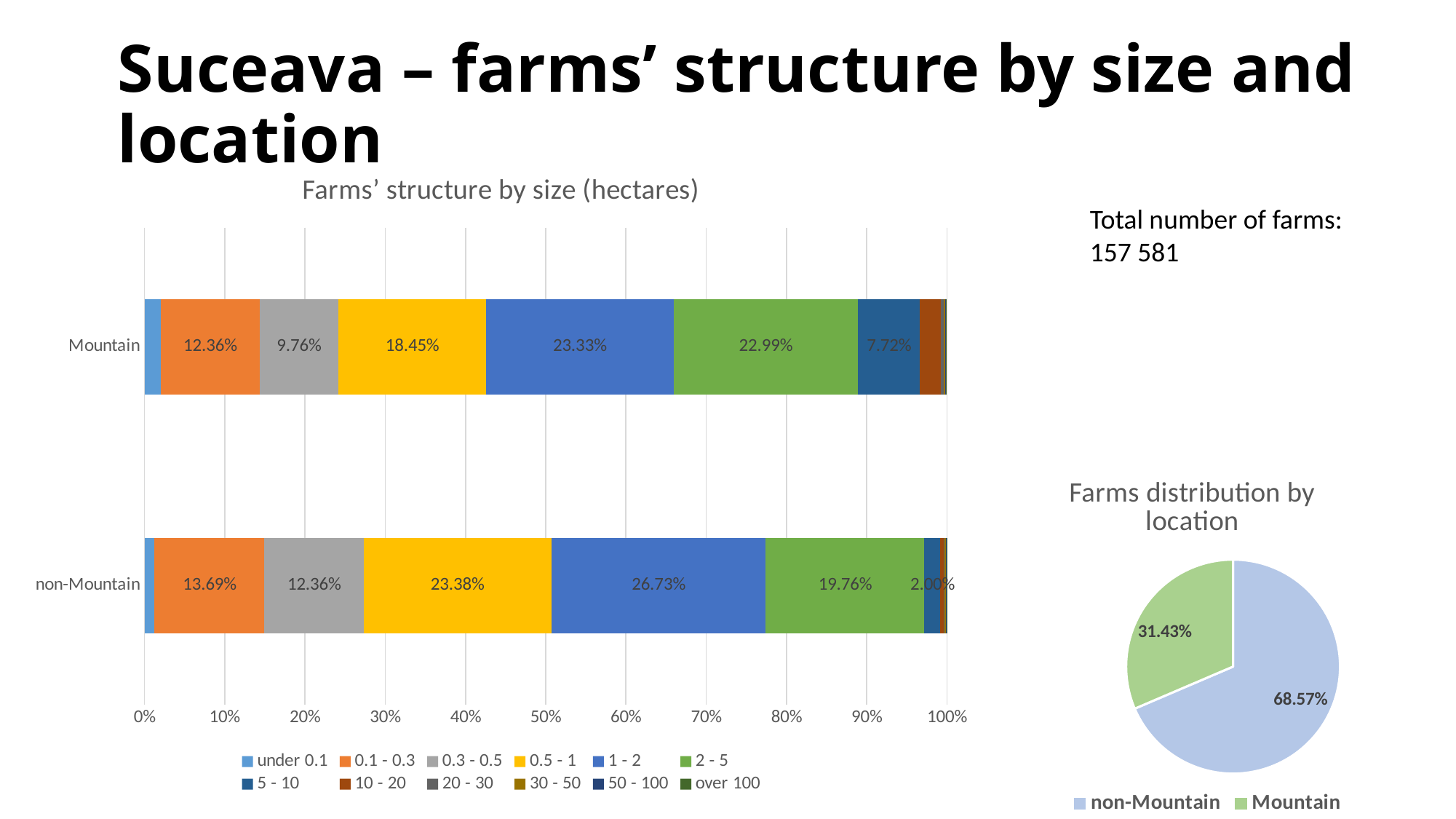
In the 'Farms distribution by location' pie chart, which location has the larger slice? non-Mountain In the 'Farms' structure by size (hectares)' chart, what is the value of the 0.5 - 1 segment for non-Mountain? 23.38% In the 'Farms' structure by size (hectares)' chart, how many series does the legend list? 12 In the 'Farms' structure by size (hectares)' chart, which is larger: the 0.3 - 0.5 share for Mountain or for non-Mountain? non-Mountain In the 'Farms' structure by size (hectares)' chart, how many location categories are plotted? 2 In the 'Farms distribution by location' pie chart, what share do Mountain farms have? 31.43% In the 'Farms' structure by size (hectares)' chart, which labelled size class has the largest share for non-Mountain? 1 - 2 In the 'Farms' structure by size (hectares)' chart, what is the value of the 5 - 10 segment for Mountain? 7.72% In the 'Farms' structure by size (hectares)' chart, what is the value of the 2 - 5 segment for non-Mountain? 19.76% In the 'Farms' structure by size (hectares)' chart, what is the value of the 1 - 2 segment for Mountain? 23.33% What kind of chart is 'Farms distribution by location'? Pie chart In the 'Farms' structure by size (hectares)' chart, what is the difference between the 0.1 - 0.3 shares for non-Mountain and Mountain? 1.33%